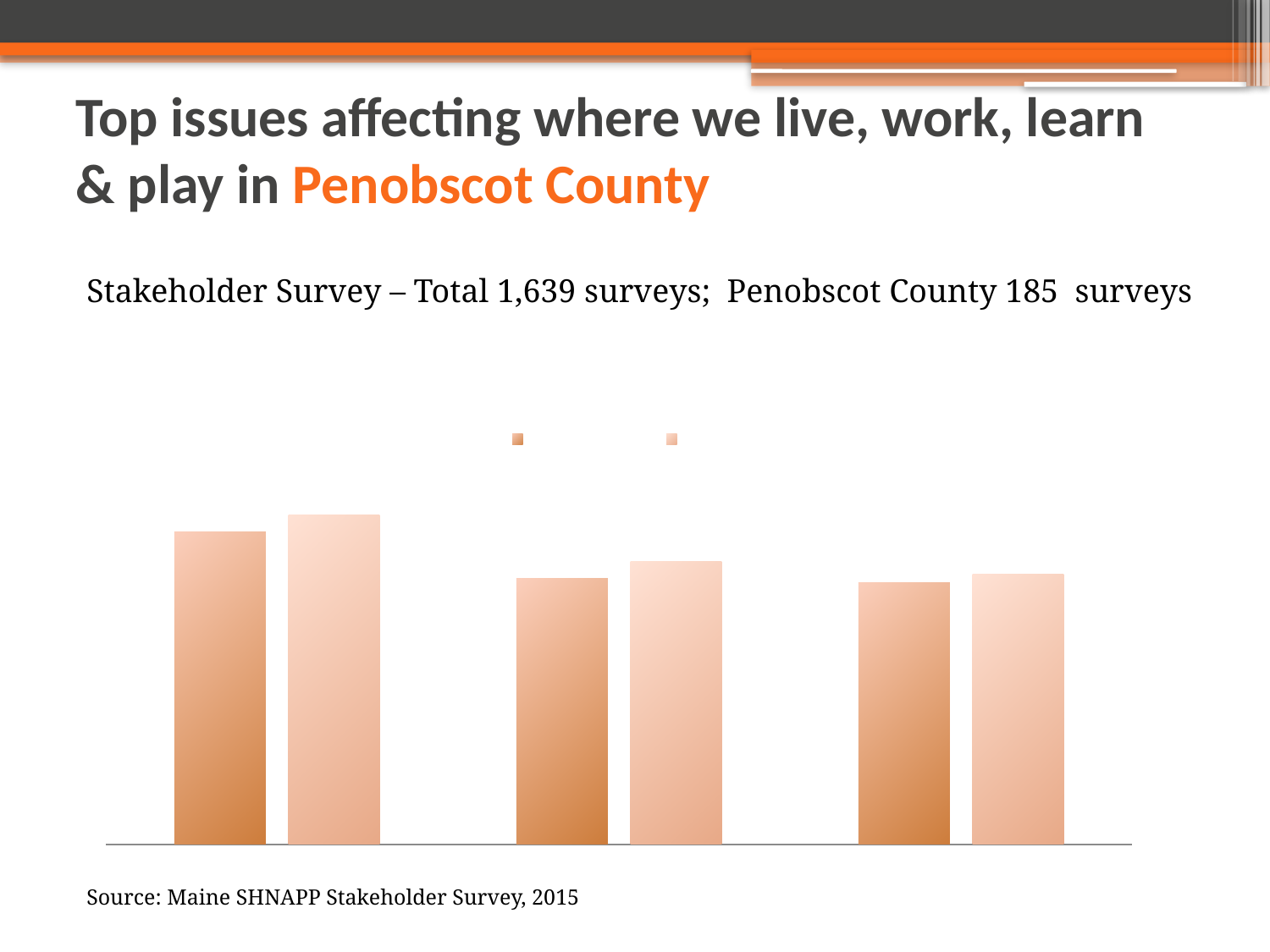
In the rightmost group of bars, is the left bar or the right bar taller? right bar Are the bars in the chart vertical or horizontal? vertical How many bars are plotted in total on the chart? 6 What colour family are the bars in the chart? orange What kind of chart is shown on the slide? bar chart How many series does the chart's legend list? 2 In the leftmost group of bars, is the left bar or the right bar taller? right bar How many groups of bars does the chart show? 3 In the middle group of bars, is the left bar or the right bar taller? right bar Which group of bars is the tallest: the leftmost, middle, or rightmost group? leftmost